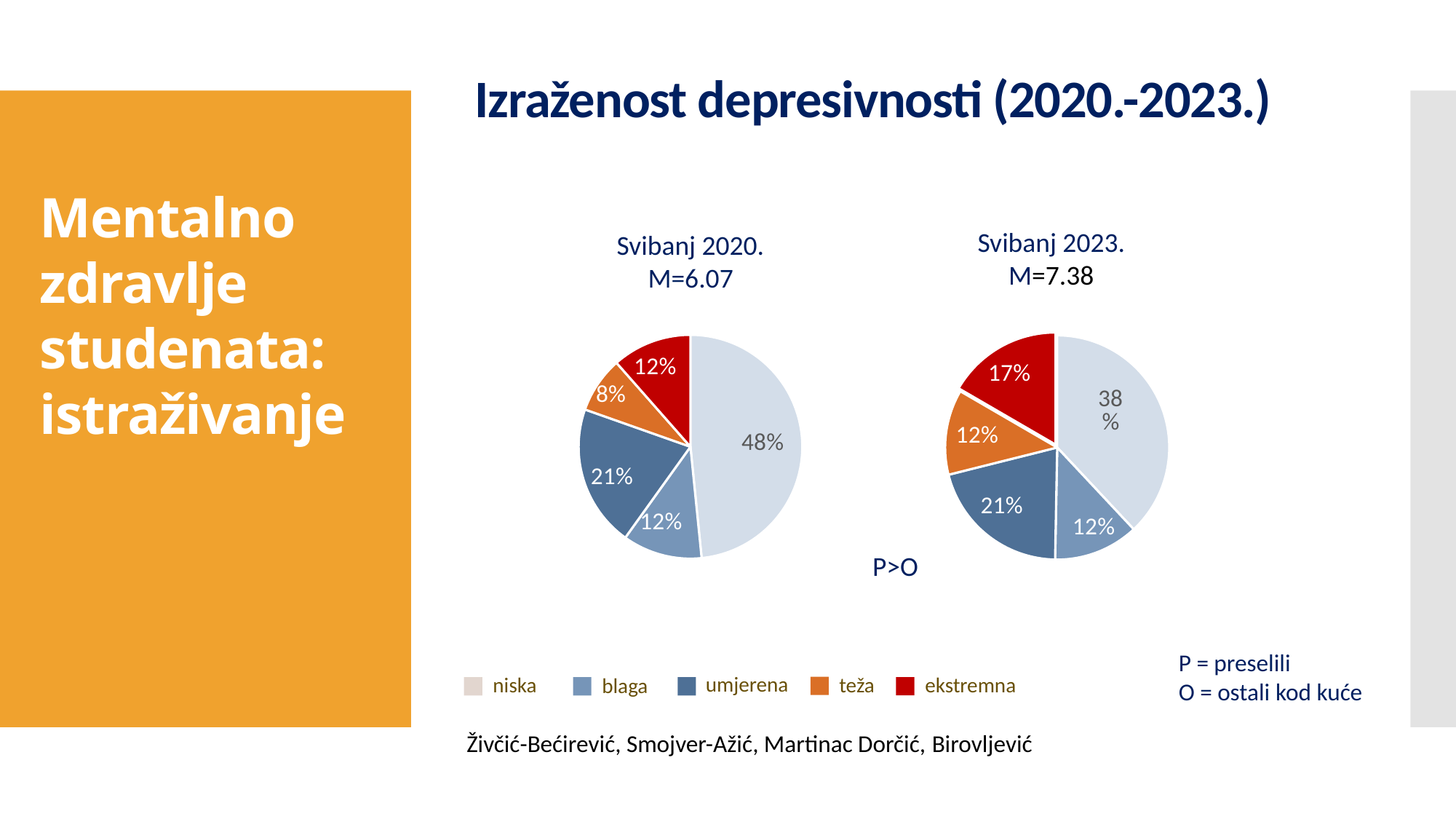
How many categories does the legend list? 5 In the Svibanj 2023. pie chart, what is the share for niska? 38% In the Svibanj 2023. pie chart, what is the share for umjerena? 21% What is the difference between the niska share in the Svibanj 2020. chart and the niska share in the Svibanj 2023. chart? 10 percentage points In the Svibanj 2023. pie chart, what is the share for ekstremna? 17% In the Svibanj 2020. pie chart, what is the share for teža? 8% Which is larger: the ekstremna share in the Svibanj 2020. chart or in the Svibanj 2023. chart? Svibanj 2023. In the Svibanj 2020. pie chart, what is the share for niska? 48% In the Svibanj 2020. pie chart, which category has the largest share? niska In the Svibanj 2023. pie chart, which category has the smallest share? blaga and teža (tied at 12%) In the Svibanj 2020. pie chart, which category has the smallest share? teža What type of charts are shown on the slide? Pie charts